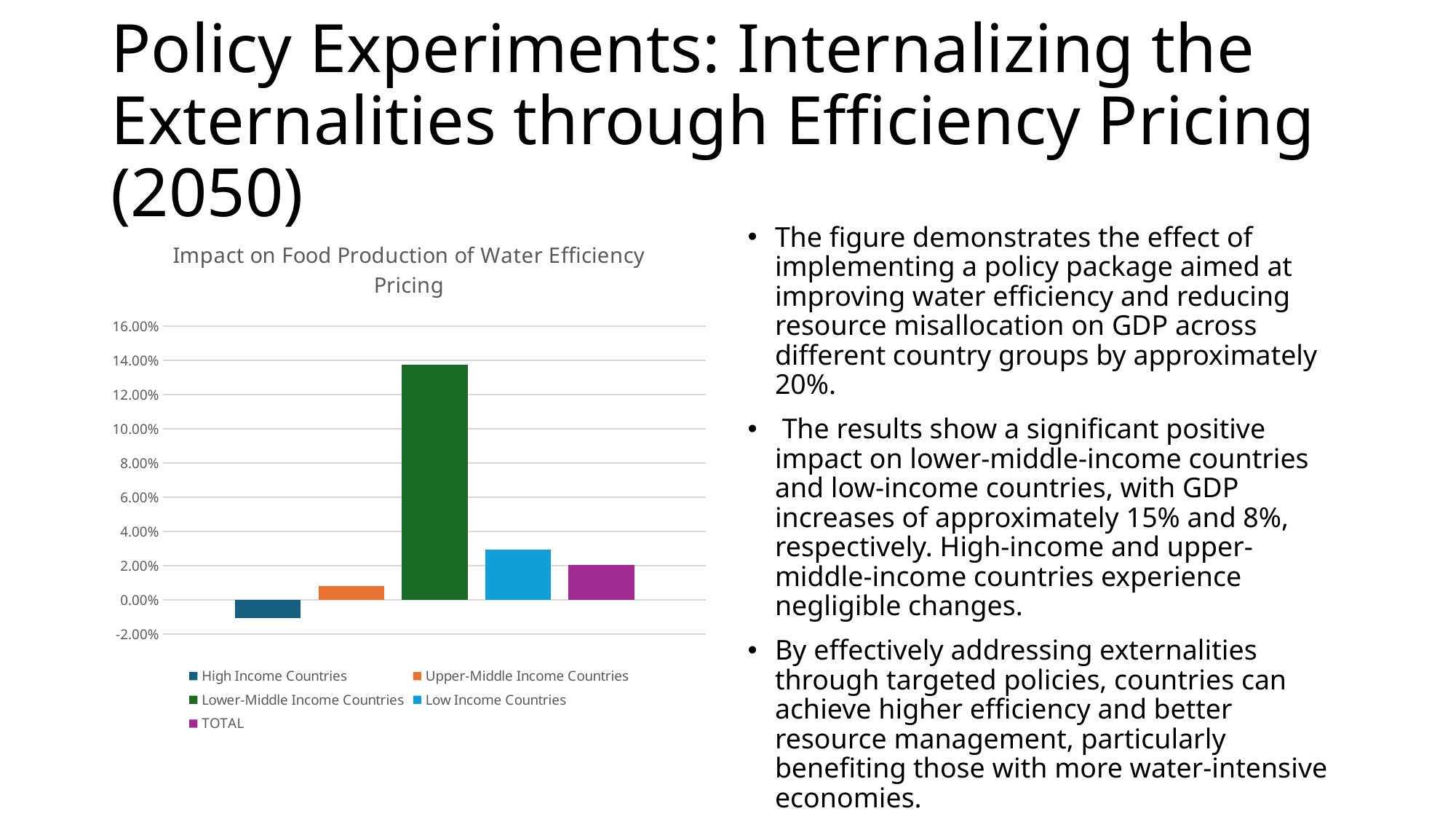
Is the value for Upper-Middle Income Countries greater or less than 2.00%? less What kind of chart is shown on the slide? Bar chart Which is larger, the value for Low Income Countries or the value for Upper-Middle Income Countries? Low Income Countries How many series does the chart legend list? 5 What colour is the bar for Lower-Middle Income Countries? Green What is the title of the chart? Impact on Food Production of Water Efficiency Pricing Is the value for Lower-Middle Income Countries greater or less than 12.00%? greater Is the value for High Income Countries greater or less than 0.00%? less How many bars are plotted in the chart? 5 Which country group has the lowest value in the chart? High Income Countries Which country group has the highest value in the chart? Lower-Middle Income Countries